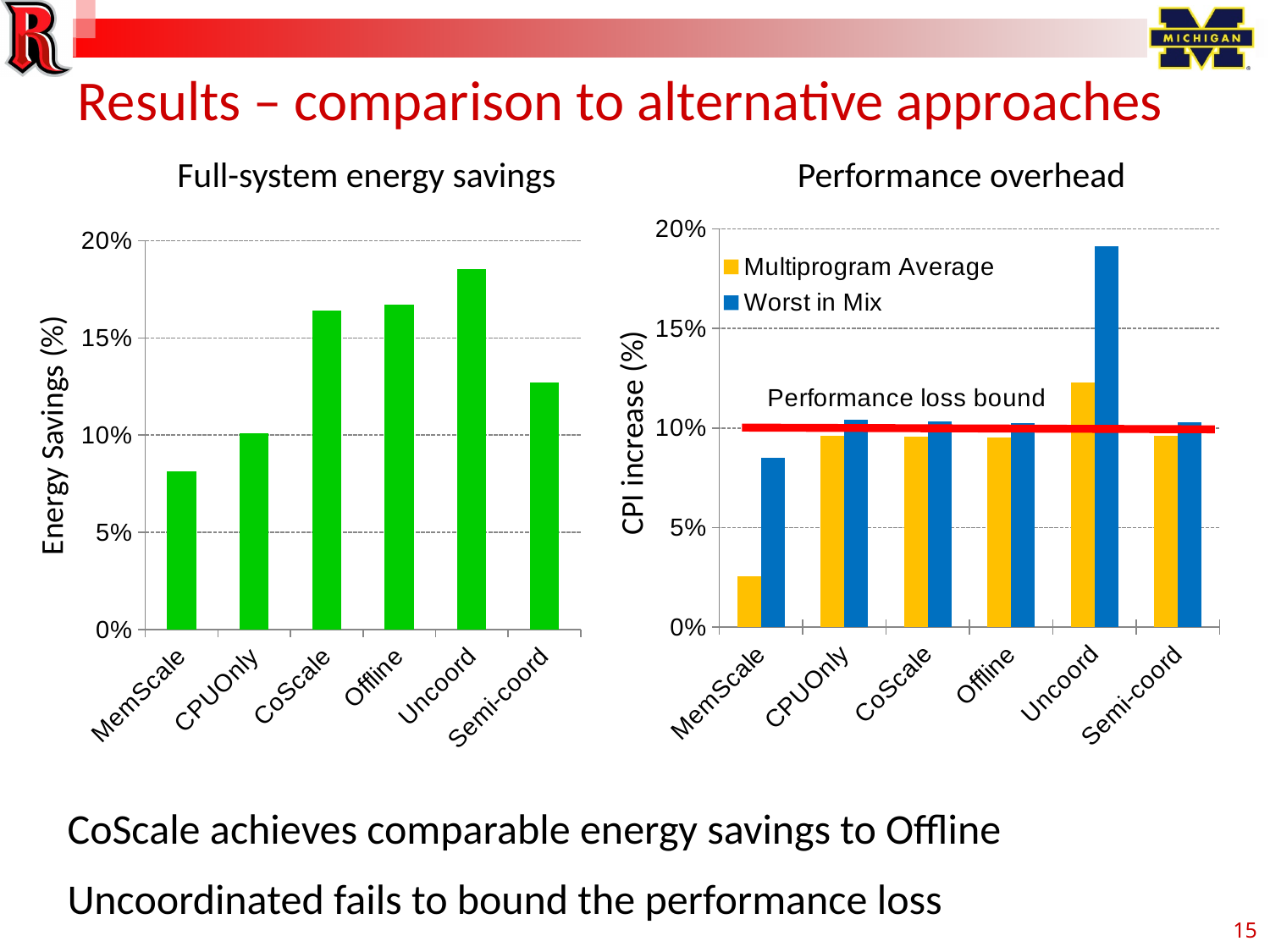
In the Performance overhead chart, which approach has the highest Worst in Mix CPI increase? Uncoord In the Full-system energy savings chart, which approach has the highest energy savings? Uncoord In the Full-system energy savings chart, which approach has the lowest energy savings? MemScale How many approaches are shown on the x axis of the Full-system energy savings chart? 6 In the Performance overhead chart, is the Worst in Mix value for Uncoord greater or less than 15%? greater In the Full-system energy savings chart, is the energy savings for MemScale greater or less than 10%? less What kind of chart is the Performance overhead chart? bar chart In the Performance overhead chart, what does the red horizontal line represent? Performance loss bound In the Full-system energy savings chart, which has higher energy savings, Uncoord or Semi-coord? Uncoord In the Full-system energy savings chart, is the energy savings for Uncoord greater or less than 15%? greater In the Performance overhead chart, which approach has the lowest Multiprogram Average CPI increase? MemScale How many series does the legend of the Performance overhead chart list? 2